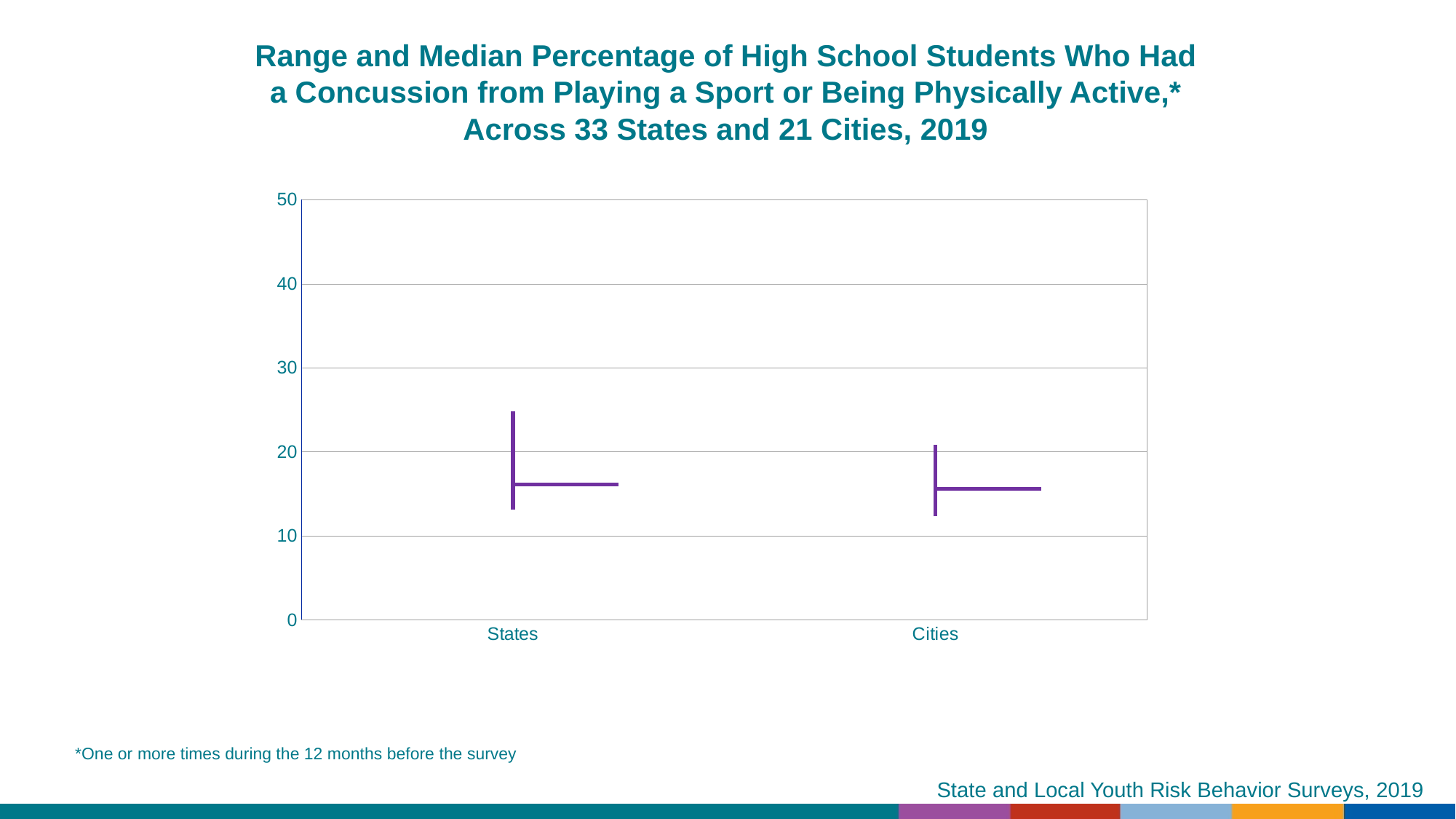
Is the bottom of the range for Cities greater or less than 10? greater Is the top of the range for States greater or less than 30? less How many categories are shown on the x axis of the chart? 2 Is the top of the range for States greater or less than 20? greater What year does the chart's title say the data are from? 2019 Which category has the higher top of its range, States or Cities? States What are the two categories shown on the x axis? States and Cities What is the highest value shown on the y axis of the chart? 50